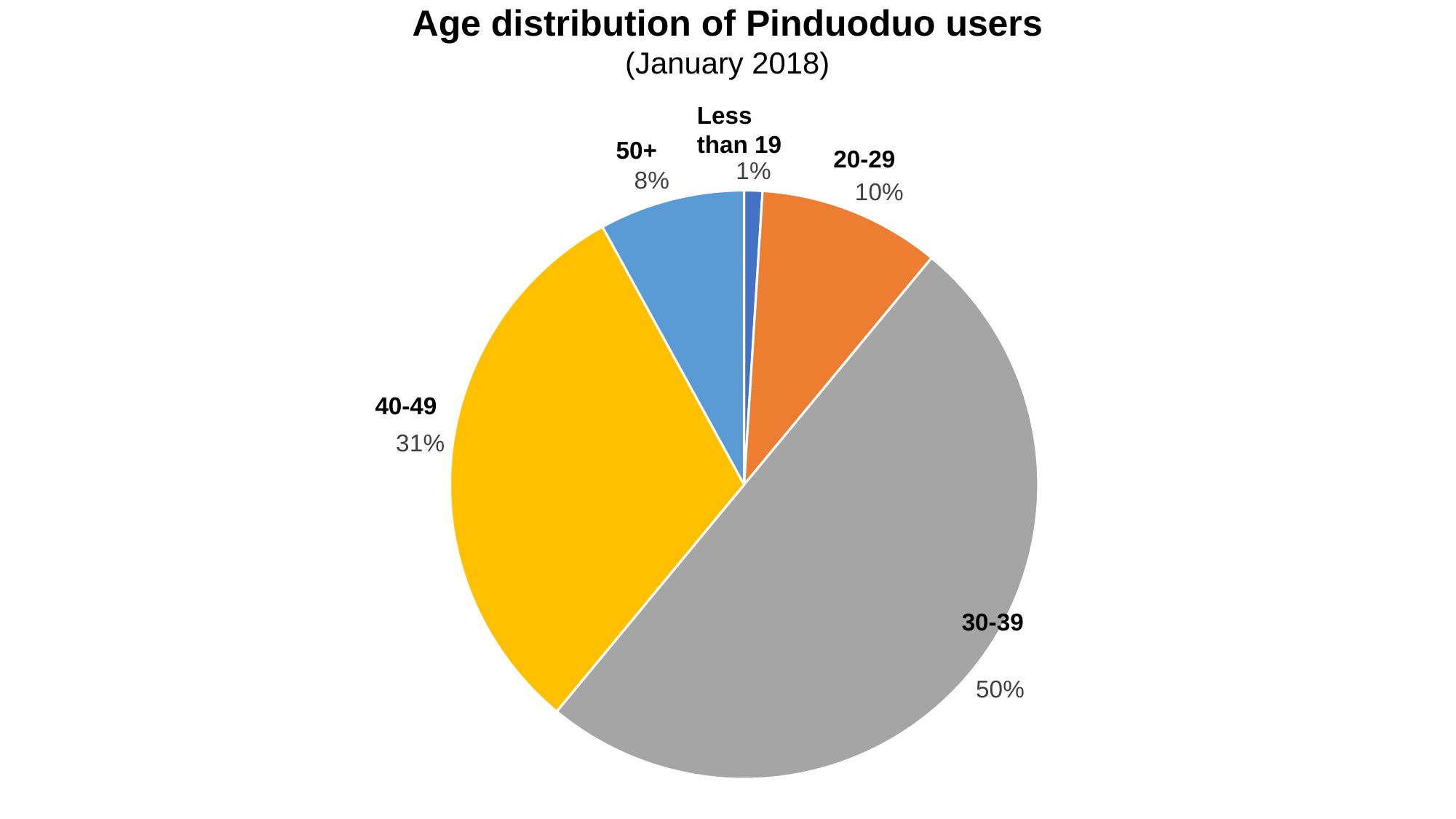
What share of Pinduoduo users are aged 30-39? 50% Which age group has the smallest share of Pinduoduo users? Less than 19 What share of Pinduoduo users are less than 19 years old? 1% What share of Pinduoduo users are aged 40-49? 31% Which age group has a larger share, 20-29 or 50+? 20-29 What share of Pinduoduo users are aged 50+? 8% What type of chart is shown on the slide? Pie chart What share of Pinduoduo users are aged 20-29? 10% Which age group has the largest share of Pinduoduo users? 30-39 What is the title of the chart? Age distribution of Pinduoduo users (January 2018) What is the difference in percentage points between the 30-39 and 40-49 age groups? 19 How many age groups are shown in the pie chart? 5